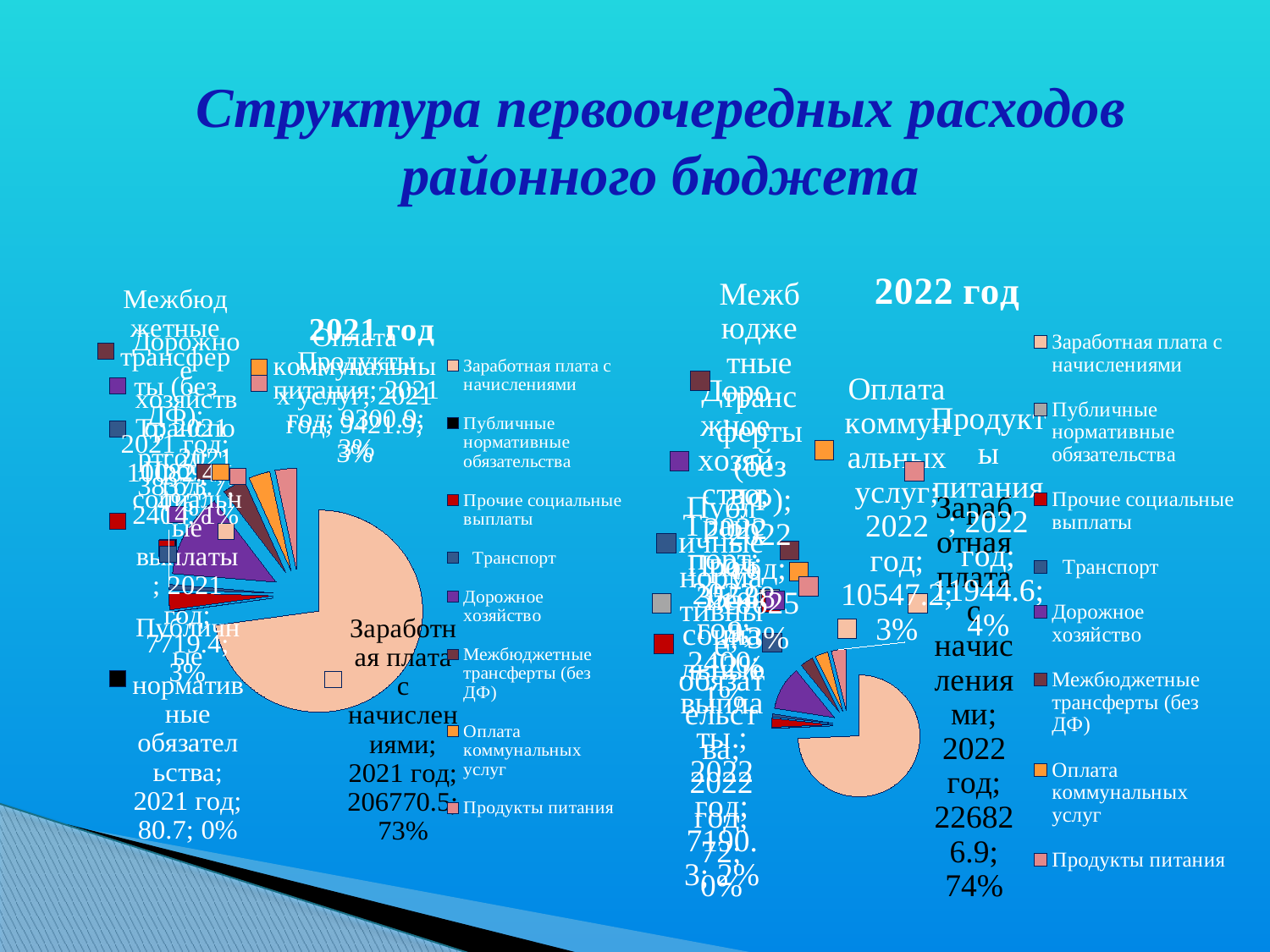
In the 2022 год chart, which category has the largest slice? Заработная плата с начислениями What kind of chart is used for the 2021 год chart? pie chart In the 2021 год chart, what is the value for Заработная плата с начислениями? 206770.5 How many entries does the legend of the 2022 год chart list? 8 In the 2022 год chart, what share of the pie is Продукты питания? 4% In the 2022 год chart, what share of the pie is Заработная плата с начислениями? 74% What kind of chart is used for the 2022 год chart? pie chart In the 2021 год chart, which category has the largest slice? Заработная плата с начислениями In the 2022 год chart, what is the value for Заработная плата с начислениями? 226826.9 In the 2021 год chart, what share of the pie is Заработная плата с начислениями? 73% In the 2021 год chart, what is the value for Публичные нормативные обязательства? 80.7 In the 2022 год chart, what is the value for Оплата коммунальных услуг? 10547.2